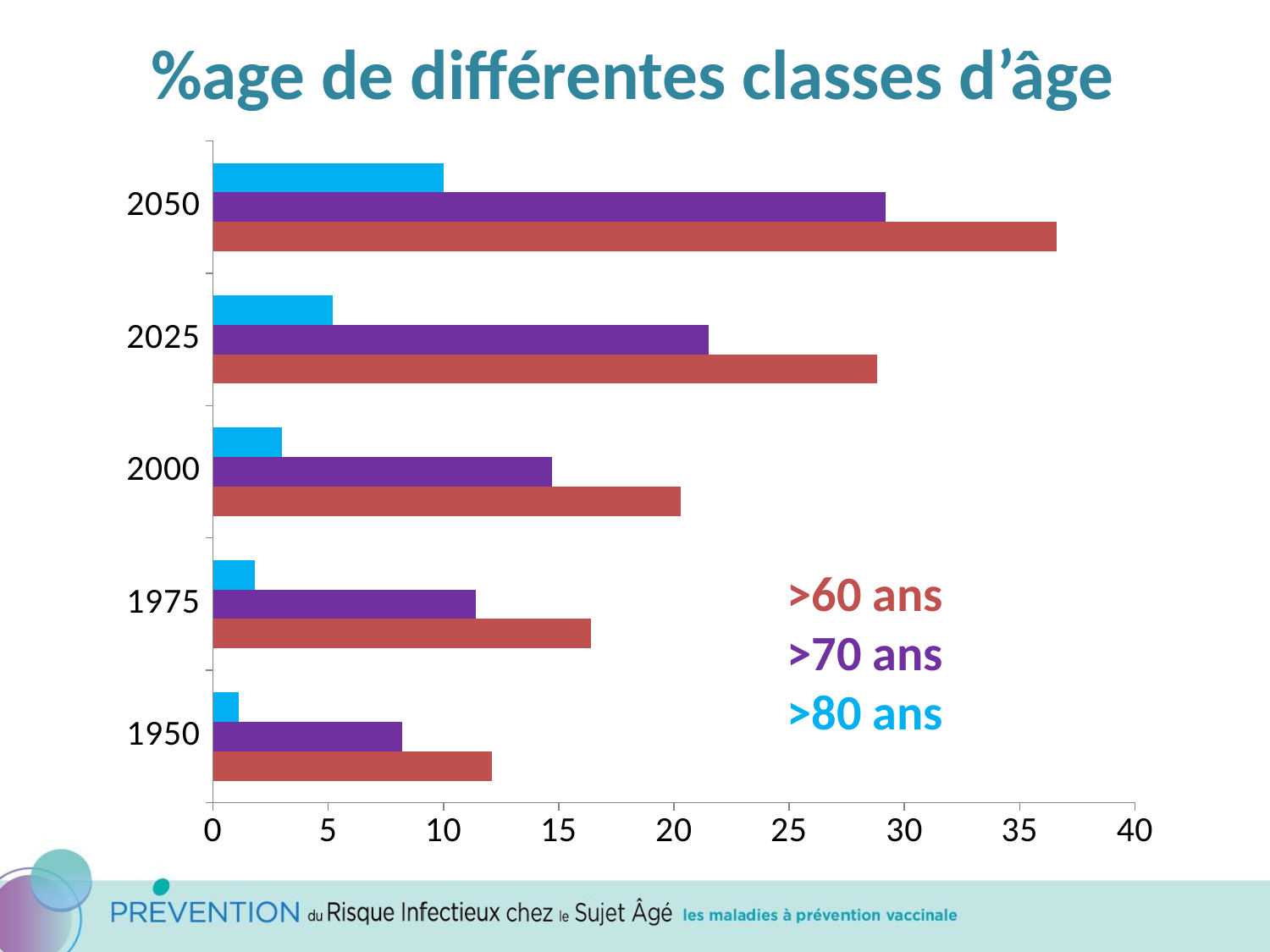
In which year is the value for >80 ans the lowest? 1950 Is the value for >60 ans in 1975 greater or less than 20? less In which year is the value for >60 ans the highest? 2050 Is the value for >70 ans in 1950 greater or less than 10? less How many years (categories) are shown on the chart? 5 Which is larger: the value for >70 ans in 2050 or the value for >60 ans in 2000? >70 ans in 2050 Which colour represents the >80 ans series? blue What kind of chart is shown on the slide? bar chart Does the value for >60 ans rise or fall from 1950 to 2050? rise What is the title of the chart? %age de différentes classes d'âge How many series does the legend list? 3 Is the value for >60 ans in 2050 greater or less than 35? greater